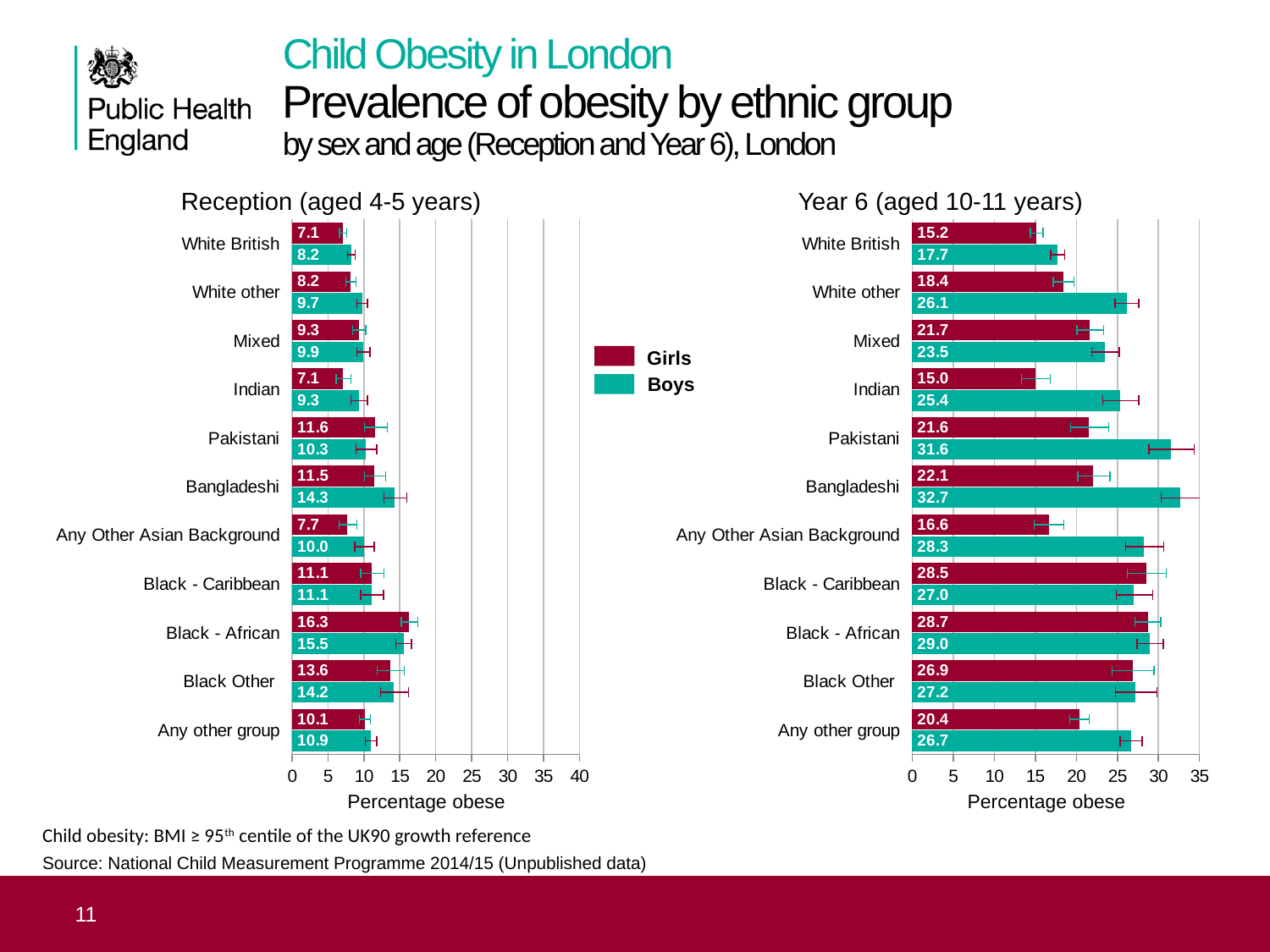
In the Reception (aged 4-5 years) chart, which is larger: the Girls value for Pakistani or the Girls value for Bangladeshi? Pakistani How many ethnic groups are shown in the Reception (aged 4-5 years) chart? 11 What is the x-axis label on the Reception (aged 4-5 years) chart? Percentage obese How many series does the legend list? 2 In the Year 6 (aged 10-11 years) chart, is the Boys value for White other greater or less than 25? greater What kind of chart is the Year 6 (aged 10-11 years) chart? Bar chart In the Year 6 (aged 10-11 years) chart, what is the difference between the Boys and Girls values for the Pakistani group? 10.0 In the Reception (aged 4-5 years) chart, what is the value for Girls in the Black - African group? 16.3 In the Reception (aged 4-5 years) chart, which ethnic group has the highest value for Boys? Black - African In the Year 6 (aged 10-11 years) chart, what is the value for Boys in the Bangladeshi group? 32.7 In the Year 6 (aged 10-11 years) chart, which ethnic group has the lowest value for Girls? Indian In the Year 6 (aged 10-11 years) chart, what is the value for Girls in the Indian group? 15.0